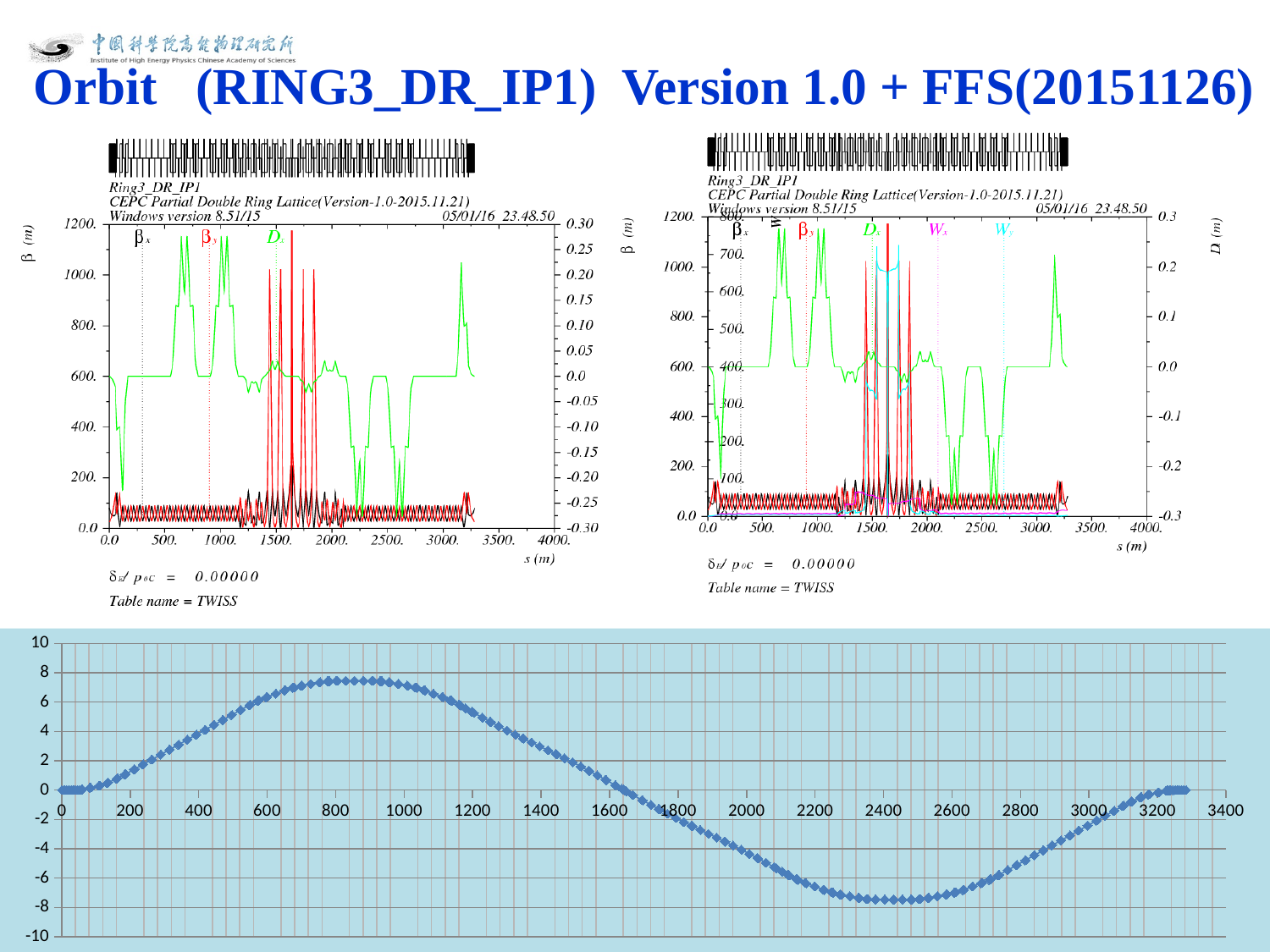
In the bottom chart, is the value at x = 2400 greater or less than -6? less In the bottom chart, do the values rise or fall as x goes from 0 to 800? rise In the bottom chart, is the value at x = 1000 larger or smaller than the value at x = 2000? larger In the bottom chart, is the value at x = 900 greater or less than 6? greater In the bottom chart, do the values rise or fall as x goes from 1000 to 2400? fall How many series does the legend of the top-left chart list? 3 What is the highest tick shown on the x axis of the bottom chart? 3400 What is the label of the left vertical axis of the top-left chart? β (m) In the bottom chart, is the value at x = 200 greater or less than 2? less How many series does the legend of the top-right chart list? 5